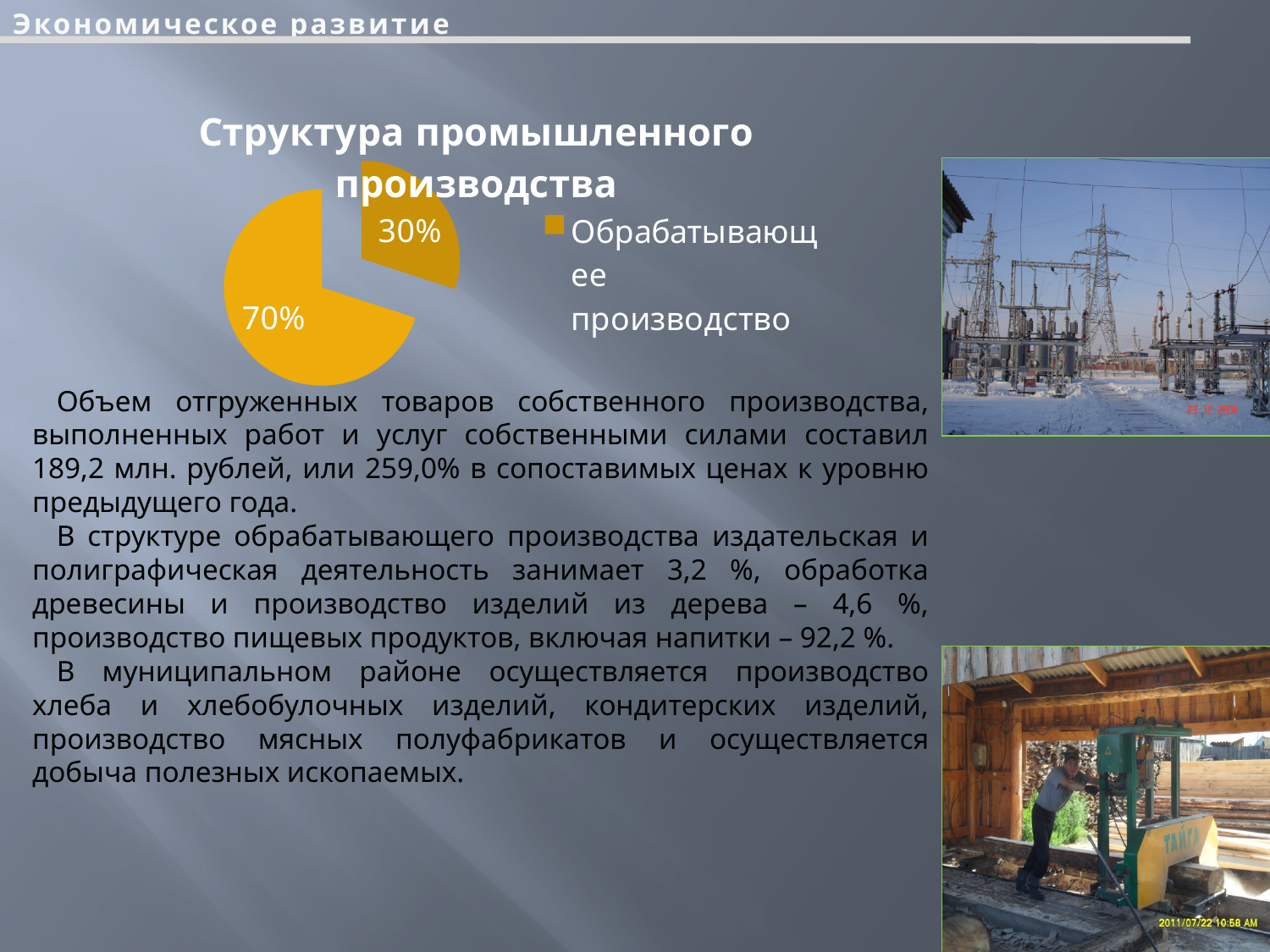
What is the value of the largest slice of the pie chart? 70% Is the largest slice of the pie chart greater or less than 50%? greater What is the difference between the two slices of the pie chart? 40 percentage points What do the two slices of the pie chart add up to? 100% What is the value of the smallest slice of the pie chart? 30% Which slice is larger: the one labelled 70% or the one labelled 30%? 70% How many slices does the pie chart have? 2 What is the title of the chart on the slide? Структура промышленного производства Which legend entry is readable next to the pie chart? Обрабатывающее производство What kind of chart is shown on the slide? pie chart What share of the pie does the exploded (separated) slice represent? 30%